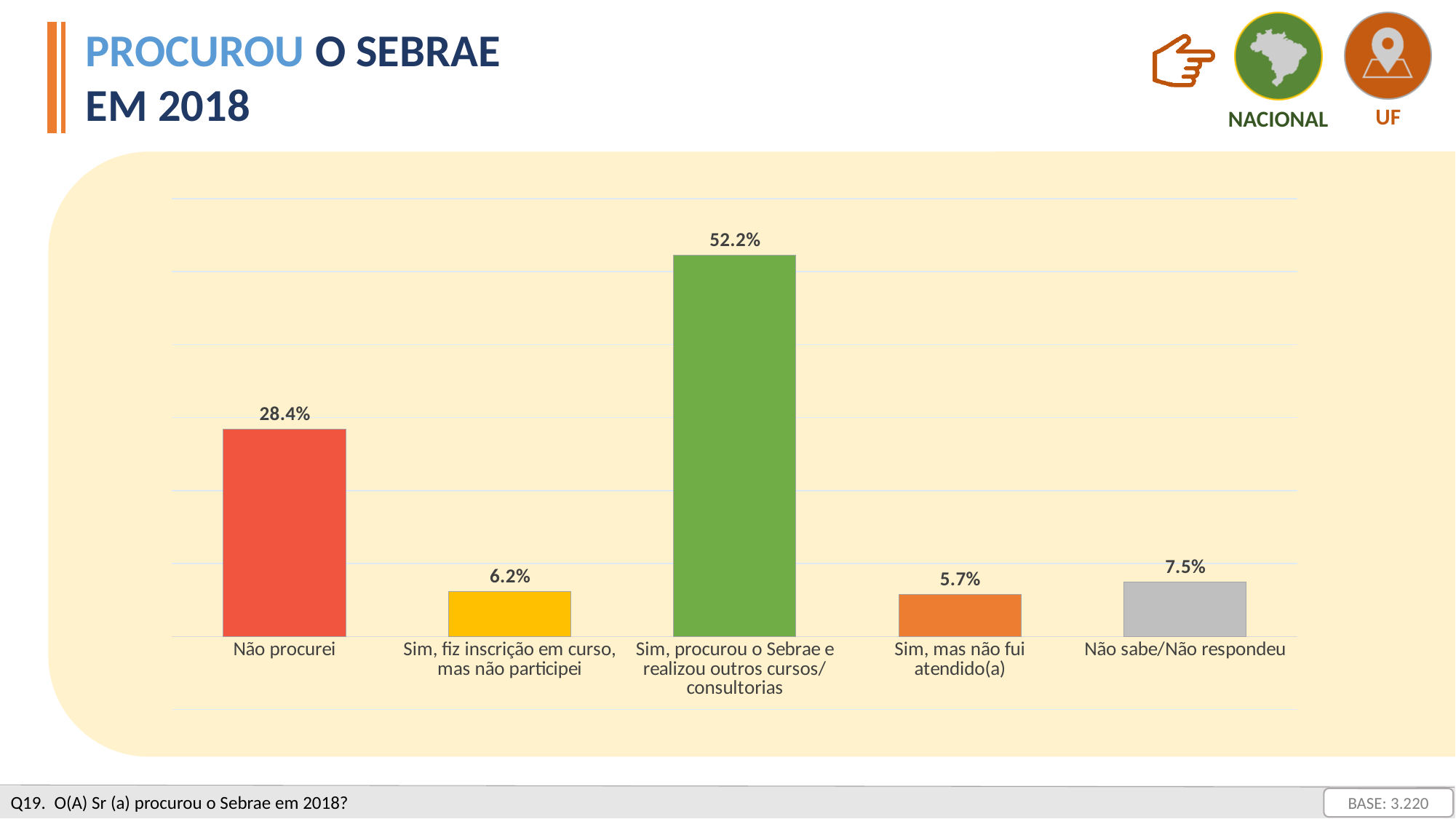
Which category has the lowest value? Sim, mas não fui atendido(a) Which is larger: the value for "Não sabe/Não respondeu" or the value for "Sim, fiz inscrição em curso, mas não participei"? Não sabe/Não respondeu What is the value for "Não sabe/Não respondeu"? 7.5% What kind of chart is shown on the slide? Bar chart What is the value for "Sim, procurou o Sebrae e realizou outros cursos/consultorias"? 52.2% What is the value for "Não procurei"? 28.4% What is the difference between the values for "Sim, procurou o Sebrae e realizou outros cursos/consultorias" and "Não procurei"? 23.8% How many categories are shown in the chart? 5 What is the value for "Sim, mas não fui atendido(a)"? 5.7% What colour is the bar for "Não procurei"? Red What is the value for "Sim, fiz inscrição em curso, mas não participei"? 6.2% Which category has the highest value? Sim, procurou o Sebrae e realizou outros cursos/consultorias